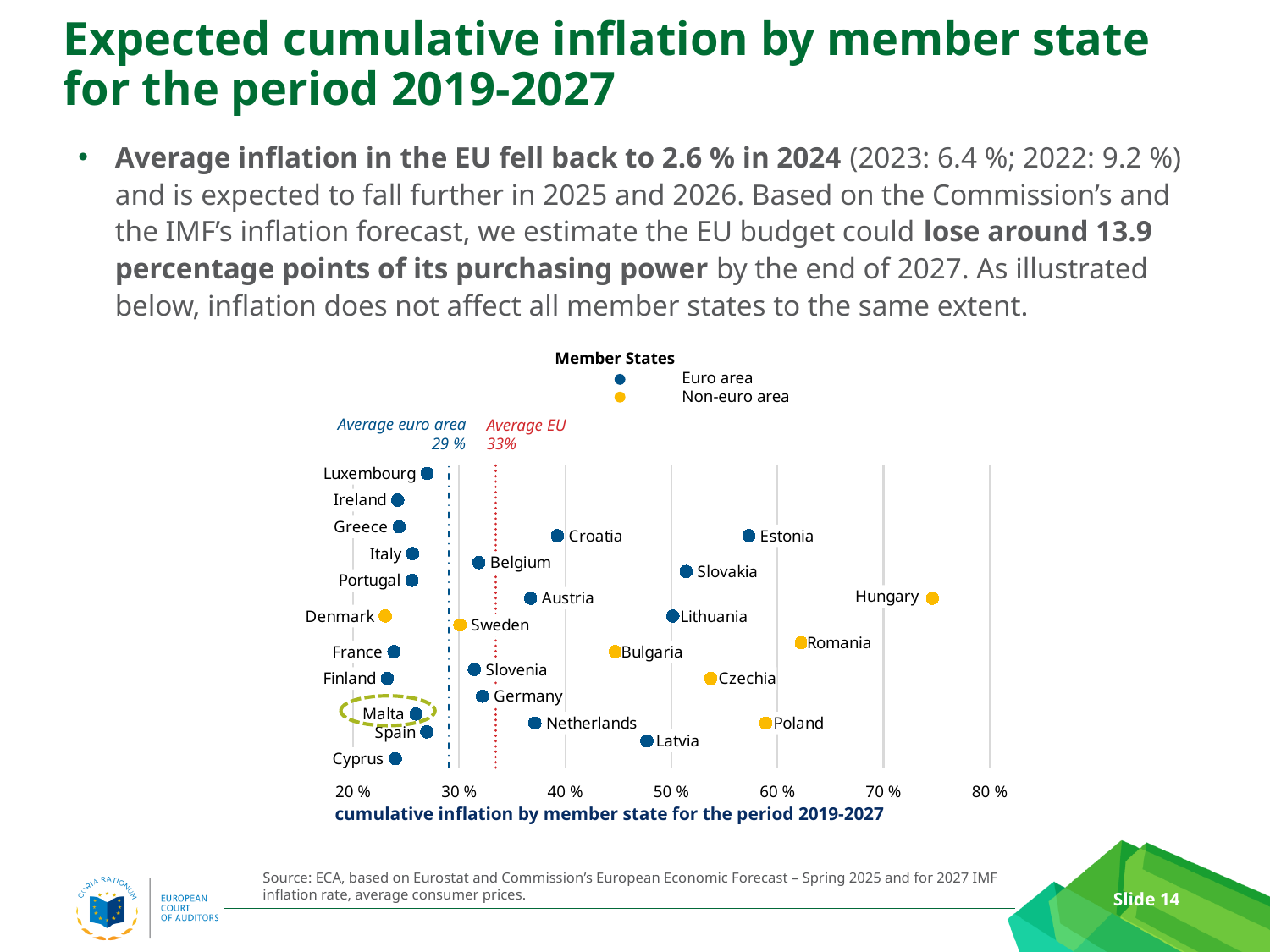
What is the average EU cumulative inflation shown on the chart? 33% Is the value for Austria greater or less than 40 %? less How many non-euro area member states are plotted on the chart? 7 What kind of chart is shown on the slide? Scatter (dot) chart How many series does the legend list? 2 Which member state is highlighted with a dashed circle on the chart? Malta Which member state has the highest expected cumulative inflation for 2019-2027? Hungary How many member states are plotted on the chart? 27 Is the value for Latvia greater or less than 50 %? less Which has the higher cumulative inflation, Romania or Hungary? Hungary Is the value for Hungary greater or less than 70 %? greater What is the average euro area cumulative inflation shown on the chart? 29 %